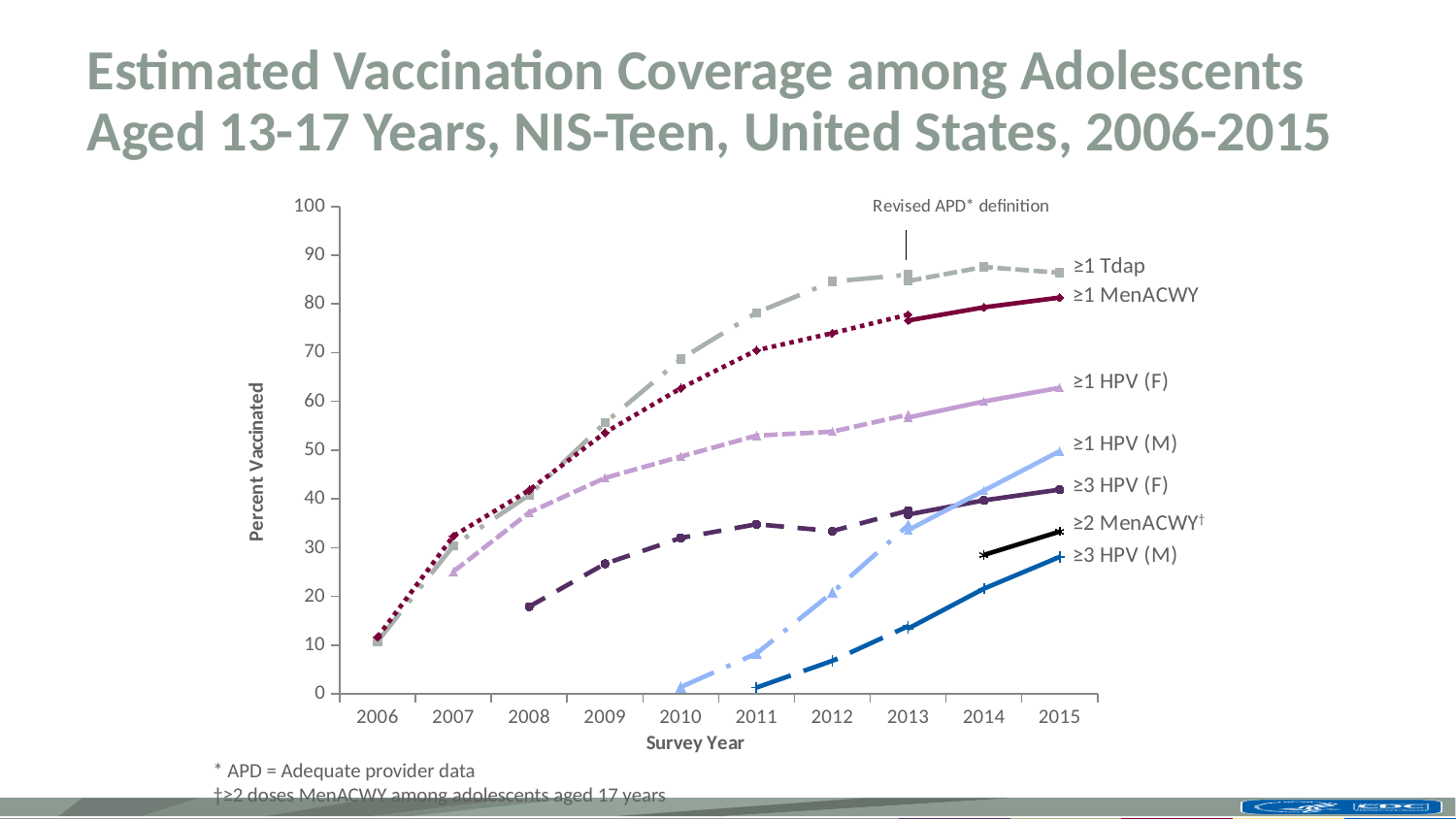
What kind of chart is shown on the slide? line chart Is the value for ≥1 Tdap in 2006 greater or less than 20? less Does the ≥1 Tdap series generally rise or fall from 2006 to 2015? rise What is the label on the x axis? Survey Year Which series has the highest value in 2015? ≥1 Tdap Is the value for ≥1 Tdap in 2015 greater or less than 80? greater In 2015, which is larger: ≥1 HPV (F) or ≥1 HPV (M)? ≥1 HPV (F) What is the label on the y axis? Percent Vaccinated Is the value for ≥3 HPV (M) in 2015 greater or less than 40? less Which series has the lowest value in 2015? ≥3 HPV (M) How many survey years are plotted along the x axis? 10 How many series are labelled on the chart? 7